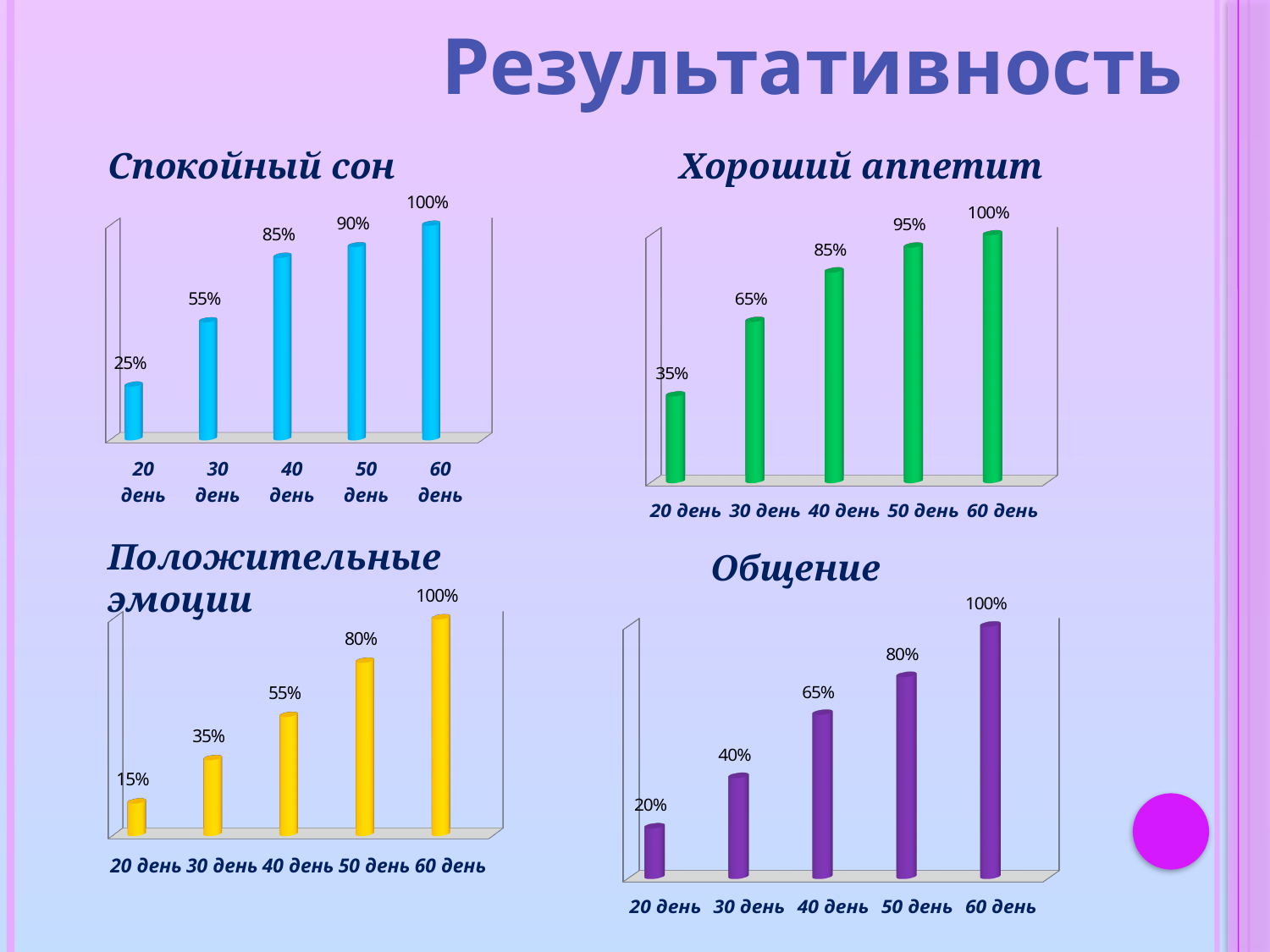
In the 'Общение' chart, which category has the highest value? 60 день What kind of chart is the 'Положительные эмоции' chart? Bar chart In the 'Общение' chart, what is the value for 30 день? 40% In the 'Хороший аппетит' chart, what is the value for 20 день? 35% In the 'Хороший аппетит' chart, what is the difference between the values for 60 день and 40 день? 15% In the 'Спокойный сон' chart, what is the difference between the values for 30 день and 20 день? 30% In the 'Спокойный сон' chart, what is the value for 40 день? 85% How many categories are shown in the 'Хороший аппетит' chart? 5 In the 'Общение' chart, which is larger: the value for 40 день or the value for 50 день? 50 день In the 'Спокойный сон' chart, do the values rise or fall from 20 день to 60 день? Rise In the 'Положительные эмоции' chart, what is the value for 50 день? 80% In the 'Положительные эмоции' chart, which category has the lowest value? 20 день